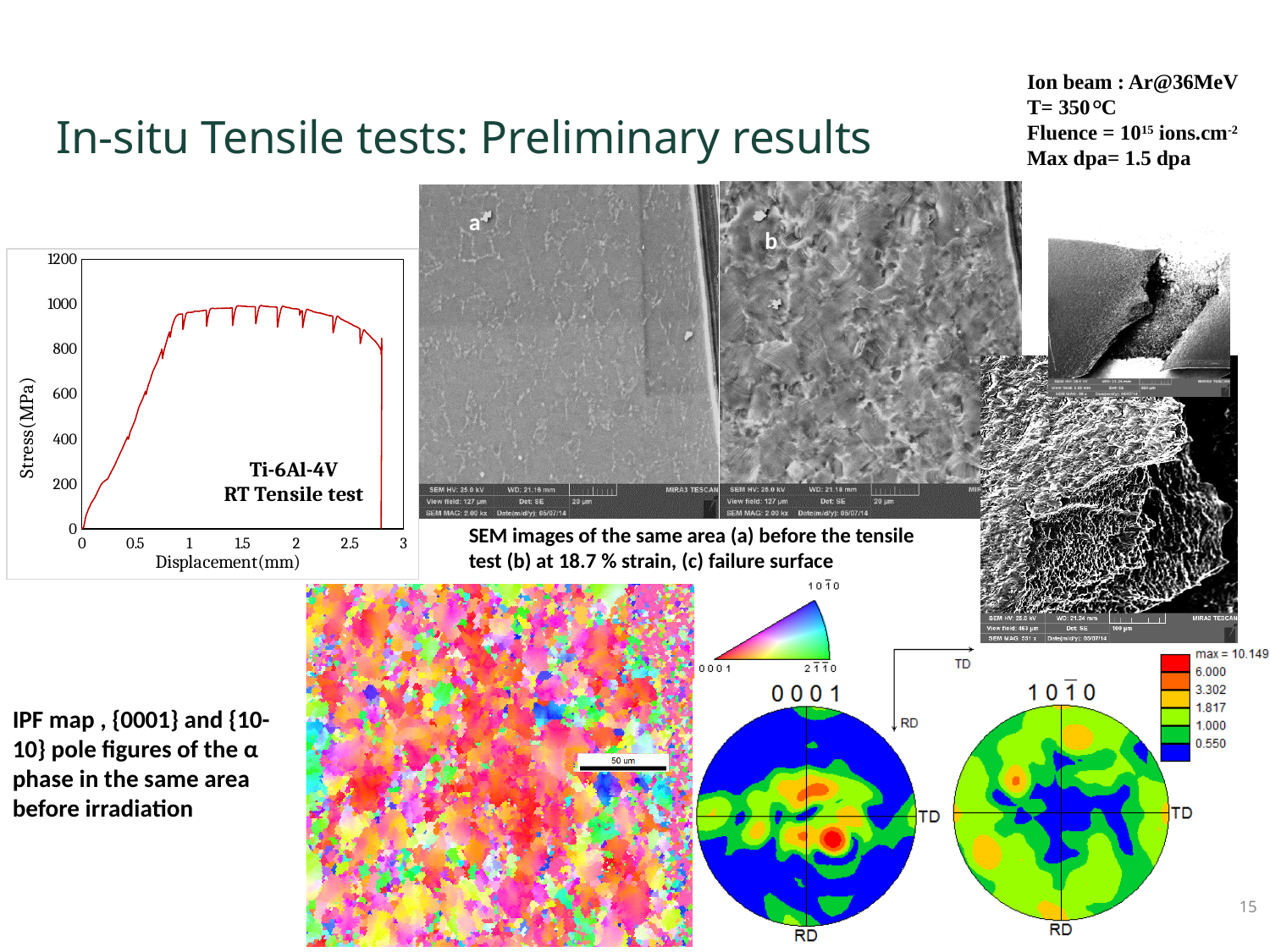
What kind of chart is the stress-displacement plot on the left of the slide? line chart In the tensile test chart, is the stress at a displacement of 0.5 mm greater or less than 800 MPa? less In the tensile test chart, is the maximum stress reached greater or less than 800 MPa? greater What is the label of the x axis of the tensile test chart? Displacement (mm) In the tensile test chart, is the displacement at which the stress drops to zero greater or less than 3 mm? less How many data series are plotted in the tensile test chart? 1 How does the stress change along the x axis in the tensile test chart between 0 and 1 mm displacement? rises What is the highest tick value shown on the y axis of the tensile test chart? 1200 What is the label of the y axis of the tensile test chart? Stress (MPa)